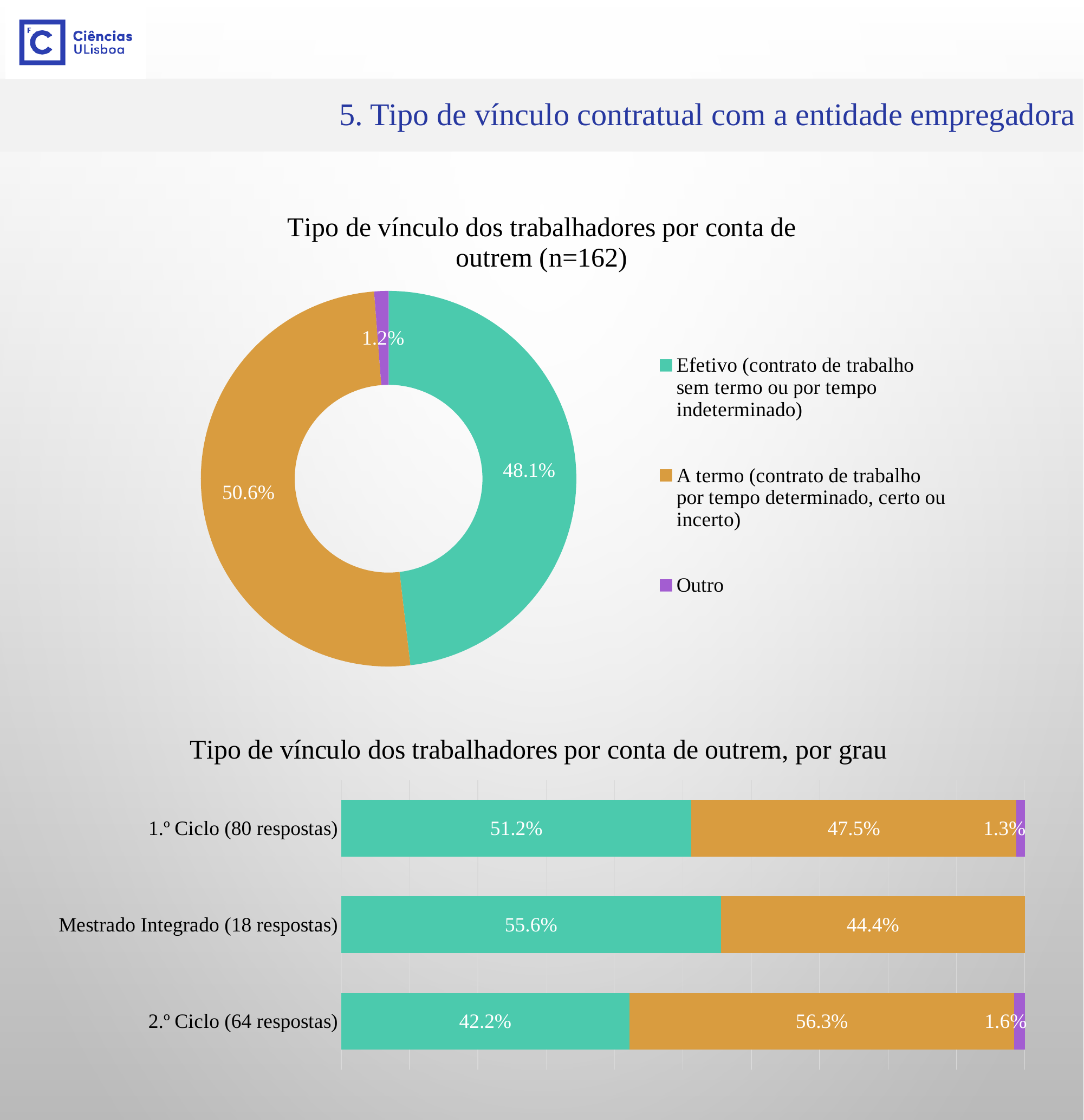
In the bottom chart 'Tipo de vínculo dos trabalhadores por conta de outrem, por grau', what is the value of the orange (A termo) segment for '2.º Ciclo (64 respostas)'? 56.3% In the top chart 'Tipo de vínculo dos trabalhadores por conta de outrem (n=162)', what percentage is shown for 'A termo (contrato de trabalho por tempo determinado, certo ou incerto)'? 50.6% In the bottom chart 'Tipo de vínculo dos trabalhadores por conta de outrem, por grau', which degree has the highest green (Efetivo) share? Mestrado Integrado (18 respostas) How many categories does the legend of the top chart 'Tipo de vínculo dos trabalhadores por conta de outrem (n=162)' list? 3 In the bottom chart 'Tipo de vínculo dos trabalhadores por conta de outrem, por grau', what is the value of the green (Efetivo) segment for 'Mestrado Integrado (18 respostas)'? 55.6% How many degree categories are shown in the bottom chart 'Tipo de vínculo dos trabalhadores por conta de outrem, por grau'? 3 In the top chart 'Tipo de vínculo dos trabalhadores por conta de outrem (n=162)', which category has the largest share? A termo (contrato de trabalho por tempo determinado, certo ou incerto) What kind of chart is the top chart 'Tipo de vínculo dos trabalhadores por conta de outrem (n=162)'? Doughnut (pie) chart What kind of chart is the bottom chart 'Tipo de vínculo dos trabalhadores por conta de outrem, por grau'? Stacked bar chart In the top chart 'Tipo de vínculo dos trabalhadores por conta de outrem (n=162)', what percentage is shown for 'Outro'? 1.2% In the top chart 'Tipo de vínculo dos trabalhadores por conta de outrem (n=162)', what is the difference in percentage points between 'A termo' and 'Efetivo'? 2.5 In the bottom chart 'Tipo de vínculo dos trabalhadores por conta de outrem, por grau', what is the value of the purple (Outro) segment for '1.º Ciclo (80 respostas)'? 1.3%